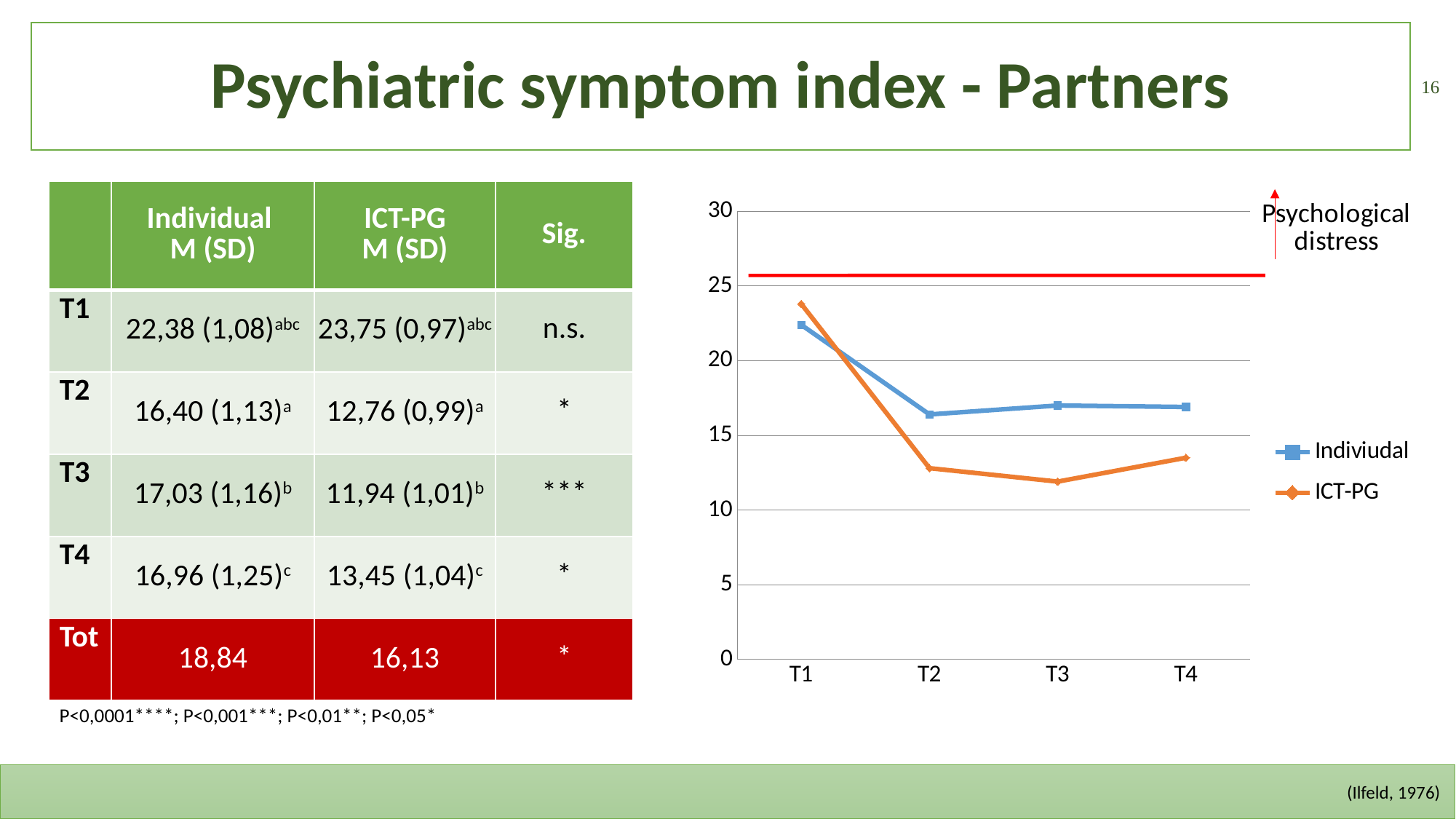
Is the value for ICT-PG at T2 greater or less than 15? less Which series has the higher value at T1 in the chart, Indiviudal or ICT-PG? ICT-PG At which time point does the ICT-PG series reach its highest value? T1 What kind of chart is shown on the slide? line chart At which time point does the Indiviudal series reach its highest value? T1 How many time points are plotted along the x axis of the chart? 4 At which time point does the ICT-PG series reach its lowest value? T3 Is the value for Indiviudal at T4 greater or less than 15? greater Do the values of the ICT-PG series rise or fall from T1 to T2? fall What colour is the line for the ICT-PG series in the chart? orange Which series has the higher value at T3 in the chart, Indiviudal or ICT-PG? Indiviudal How many series does the chart legend list? 2